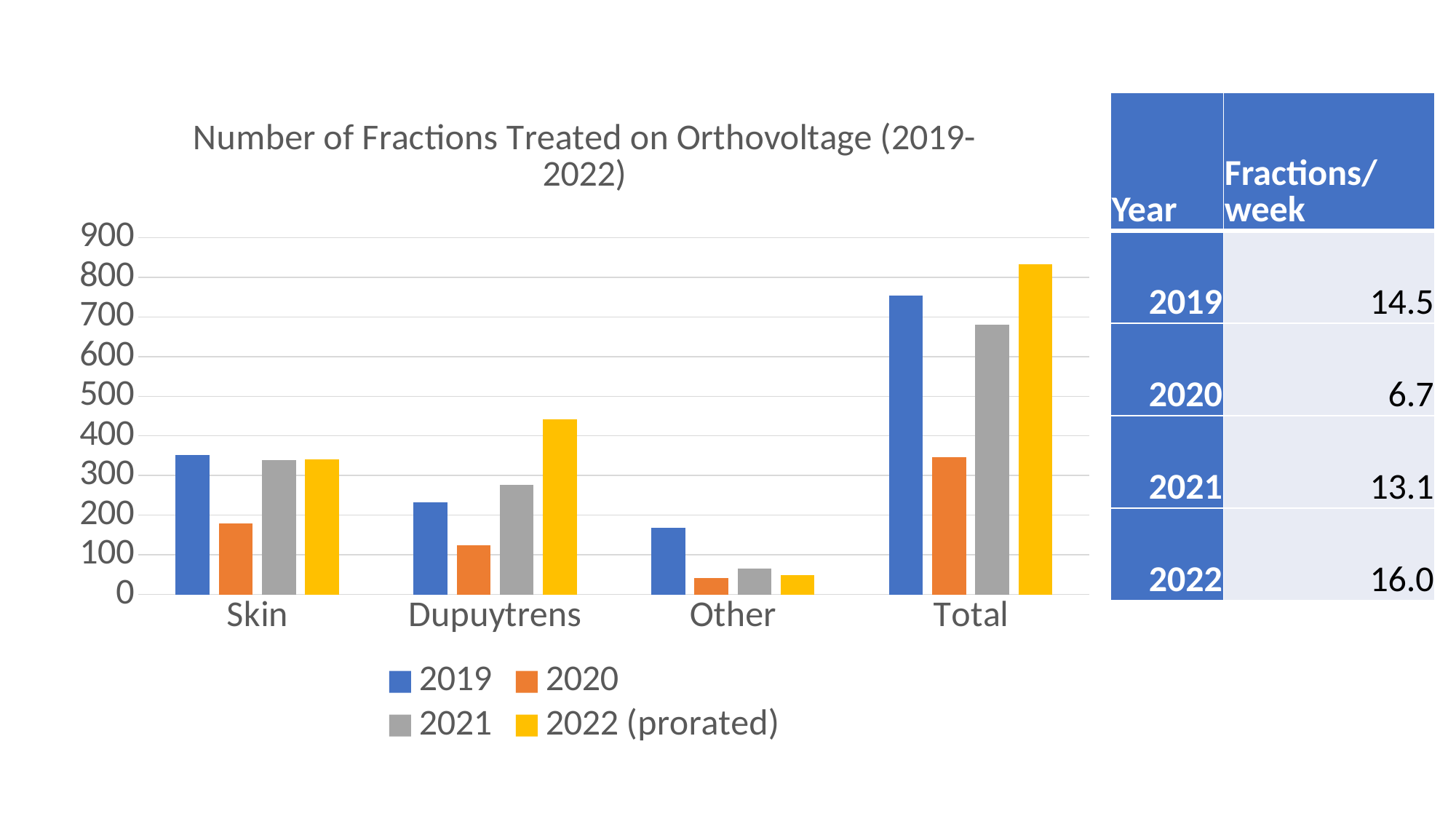
What is the title of the chart? Number of Fractions Treated on Orthovoltage (2019-2022) What kind of chart is shown on the slide? bar chart For Dupuytrens, which is larger: the 2019 bar or the 2021 bar? 2021 How many categories are shown on the x axis of the chart? 4 Is the 2020 value for Skin greater or less than 200? less Is the 2020 value for Total greater or less than 400? less In the Total category, which year has the lowest bar? 2020 Which category has the tallest 2022 (prorated) bar? Total How many series does the chart legend list? 4 Is the 2022 (prorated) value for Dupuytrens greater or less than 400? greater For Other, which is larger: the 2019 bar or the 2020 bar? 2019